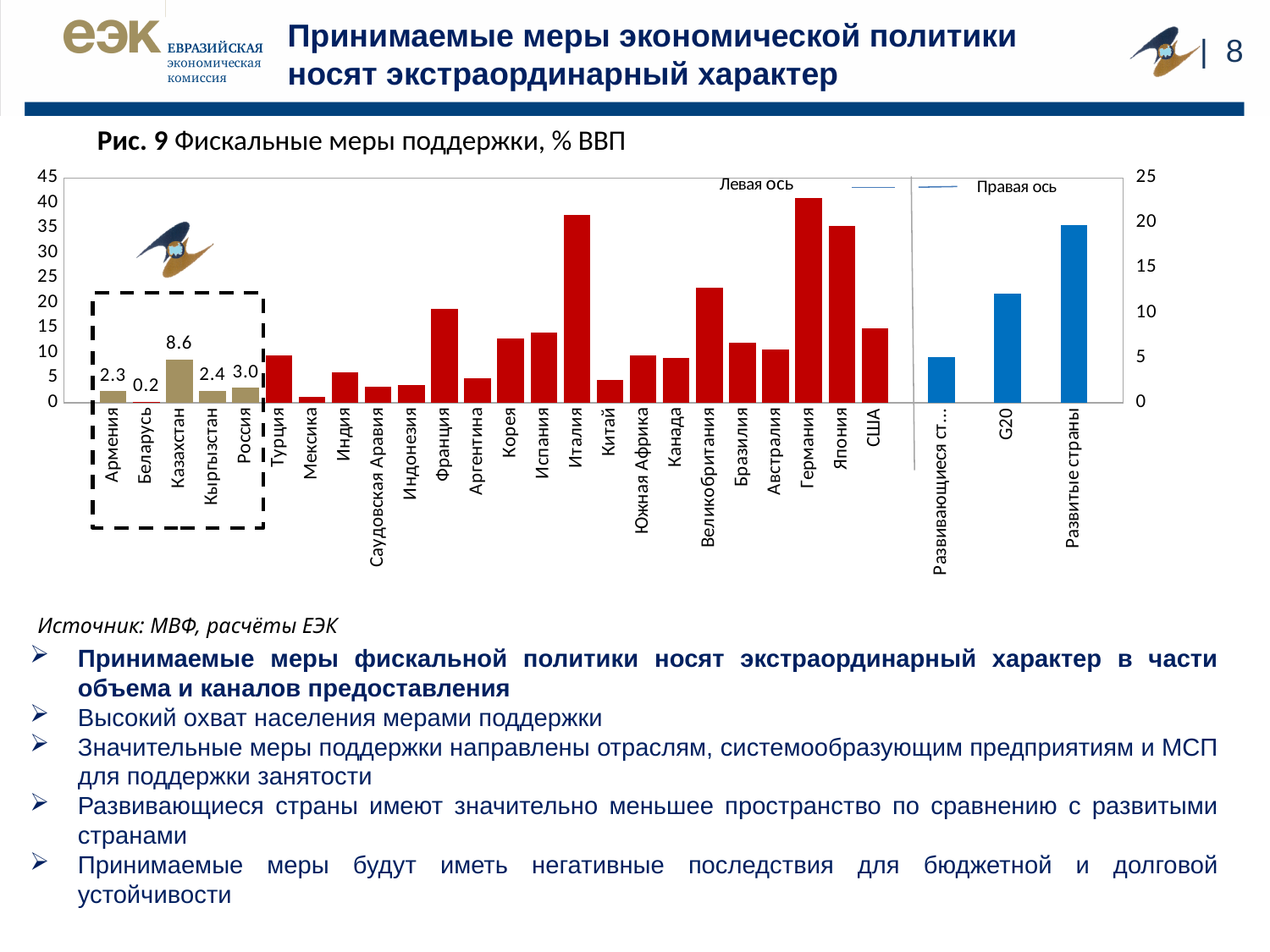
Is the value for Франция greater or less than 15? greater Which country has the tallest bar on the left axis in the chart? Германия How many countries are shown inside the dashed box in the chart? 5 What is the difference between the values for Казахстан and Россия? 5.6 Which has the larger value, Россия or Кыргызстан? Россия Is the value for Италия greater or less than 30? greater What is the value for Беларусь in the chart? 0.2 What is the value for Россия in the chart? 3.0 Among the five countries inside the dashed box, which has the lowest value? Беларусь What kind of chart is shown on the slide? Bar chart Among the five countries inside the dashed box (Армения, Беларусь, Казахстан, Кыргызстан, Россия), which has the highest value? Казахстан What is the value for Казахстан in the chart 'Фискальные меры поддержки, % ВВП'? 8.6